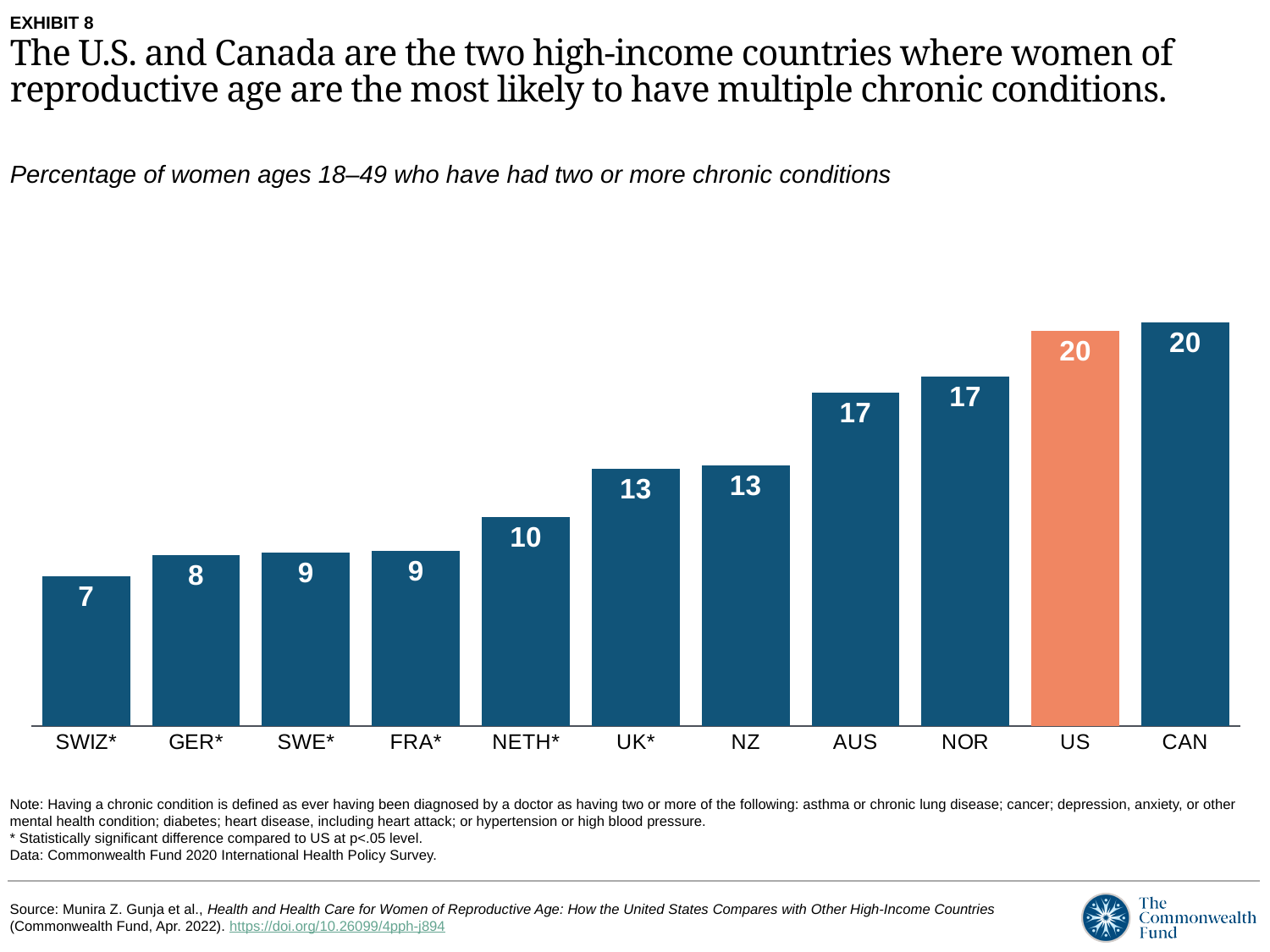
What kind of chart is shown on the slide? Bar chart Which category has the lowest value? SWIZ* What is the value for NETH*? 10 How many categories are shown on the x axis? 11 Which is larger, the value for FRA* or the value for NETH*? NETH* Which is larger, the value for GER* or the value for NZ? NZ Which bar is shown in a different colour (orange) from the others? US What is the value for SWIZ*? 7 What is the difference between the values for NOR and UK*? 4 What is the value for AUS? 17 Do the values generally rise or fall from left to right along the x axis? Rise What is the difference between the values for CAN and SWIZ*? 13